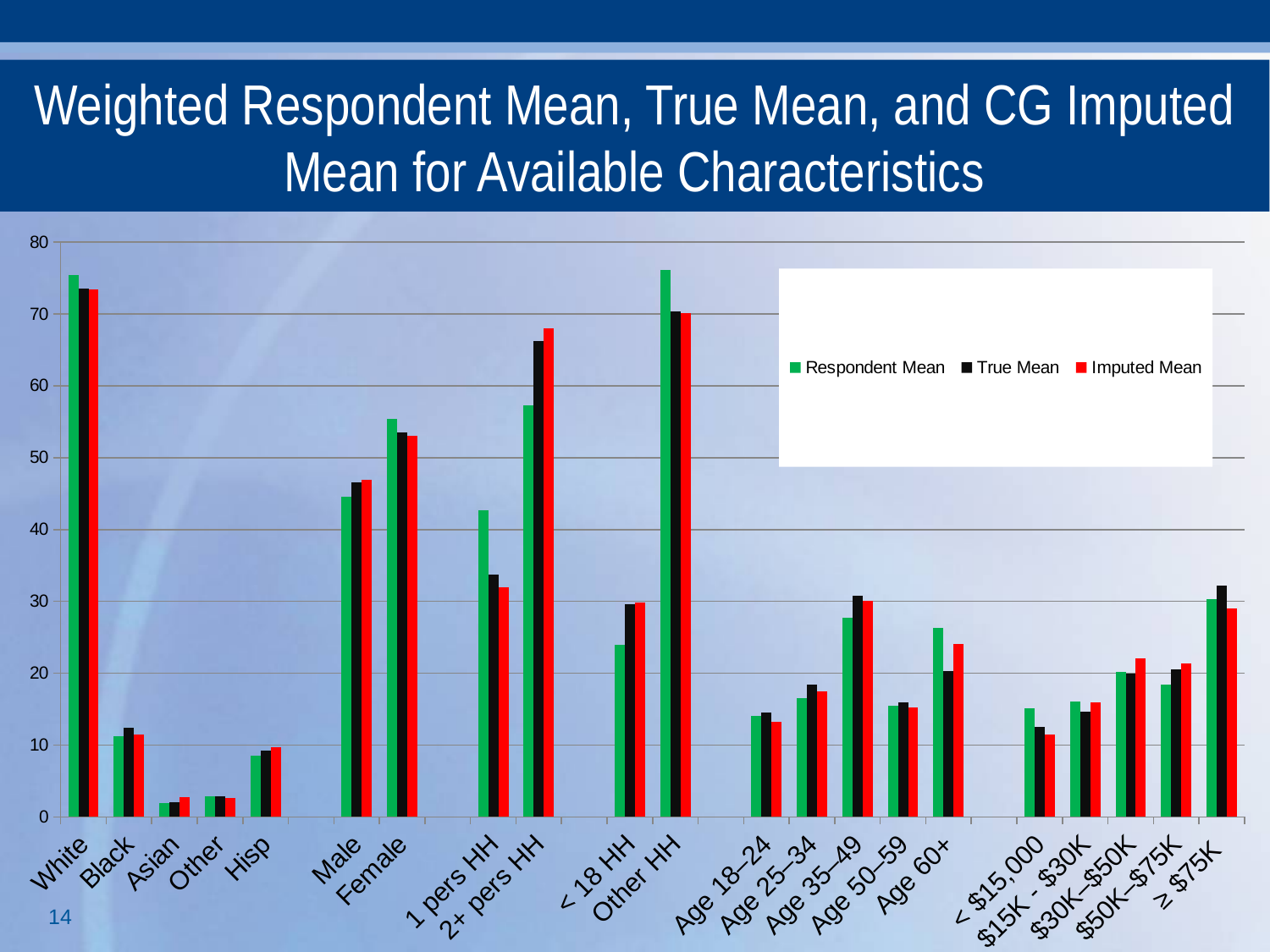
How many categories are shown along the x axis? 21 Is the Imputed Mean for Asian greater or less than 10? less What kind of chart is shown on the slide? bar chart How many series does the legend list? 3 Is the Respondent Mean for Age 60+ greater or less than 20? greater For 1 pers HH, which is larger: the Respondent Mean or the True Mean? Respondent Mean Which colour represents the Imputed Mean series in the legend? red Which category has the lowest Respondent Mean? Asian Is the Respondent Mean for White greater or less than 70? greater Which category has the highest True Mean? White For 2+ pers HH, which is larger: the Respondent Mean or the Imputed Mean? Imputed Mean